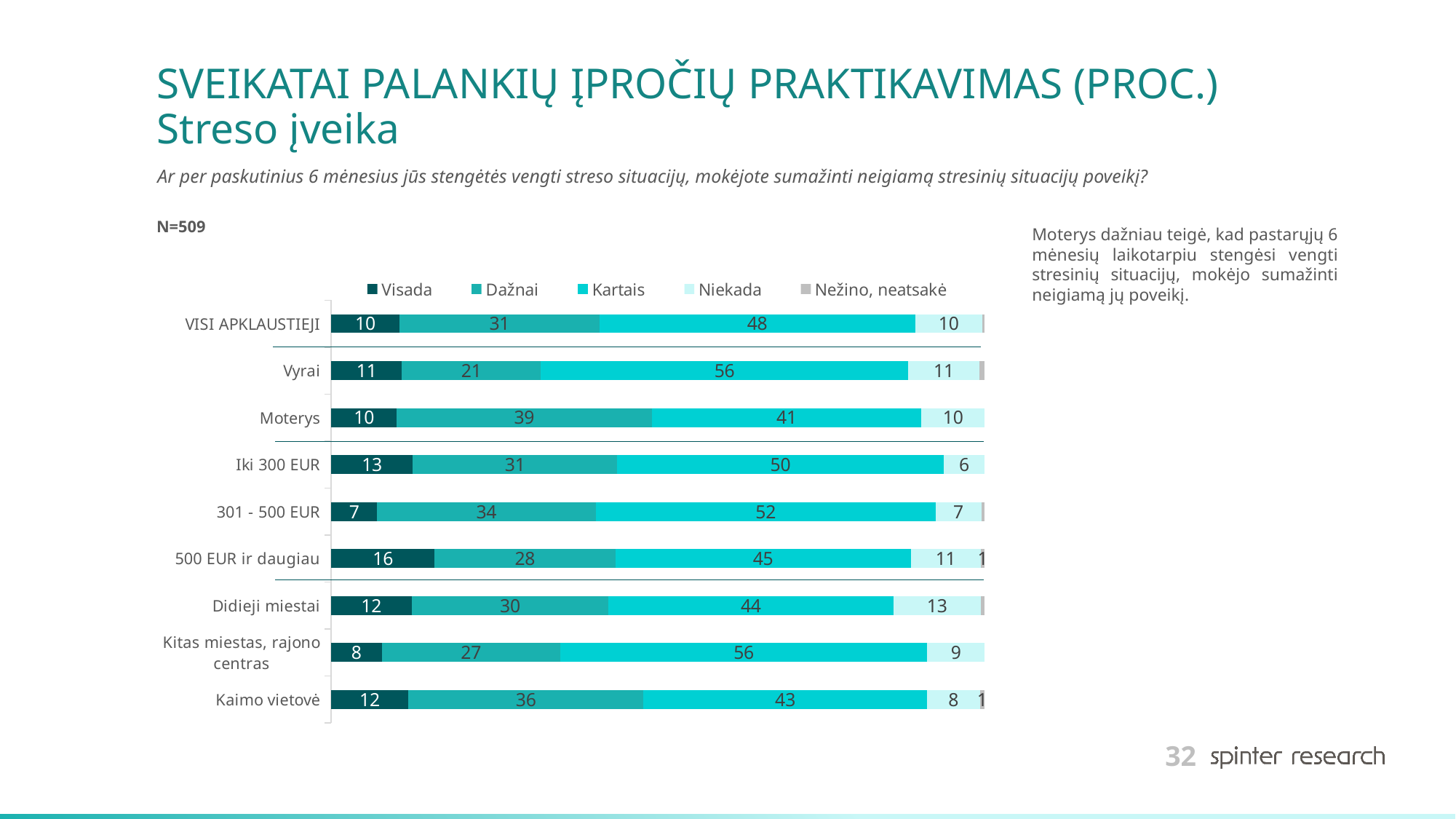
What is the difference between the "Dažnai" values for Moterys and Vyrai? 18 What is the value of "Kartais" for Vyrai? 56 How many series does the legend list? 5 Which category has the highest "Visada" value? 500 EUR ir daugiau What kind of chart is shown on the slide? Stacked bar chart Which category has the lowest "Visada" value? 301 - 500 EUR What is the value of "Visada" for "500 EUR ir daugiau"? 16 What is the total of the stacked bar for Kaimo vietovė? 100 What is the value of "Niekada" for Didieji miestai? 13 What is the value of "Dažnai" for Moterys? 39 How many categories are shown on the chart? 9 Which has a larger "Kartais" value, Vyrai or Moterys? Vyrai